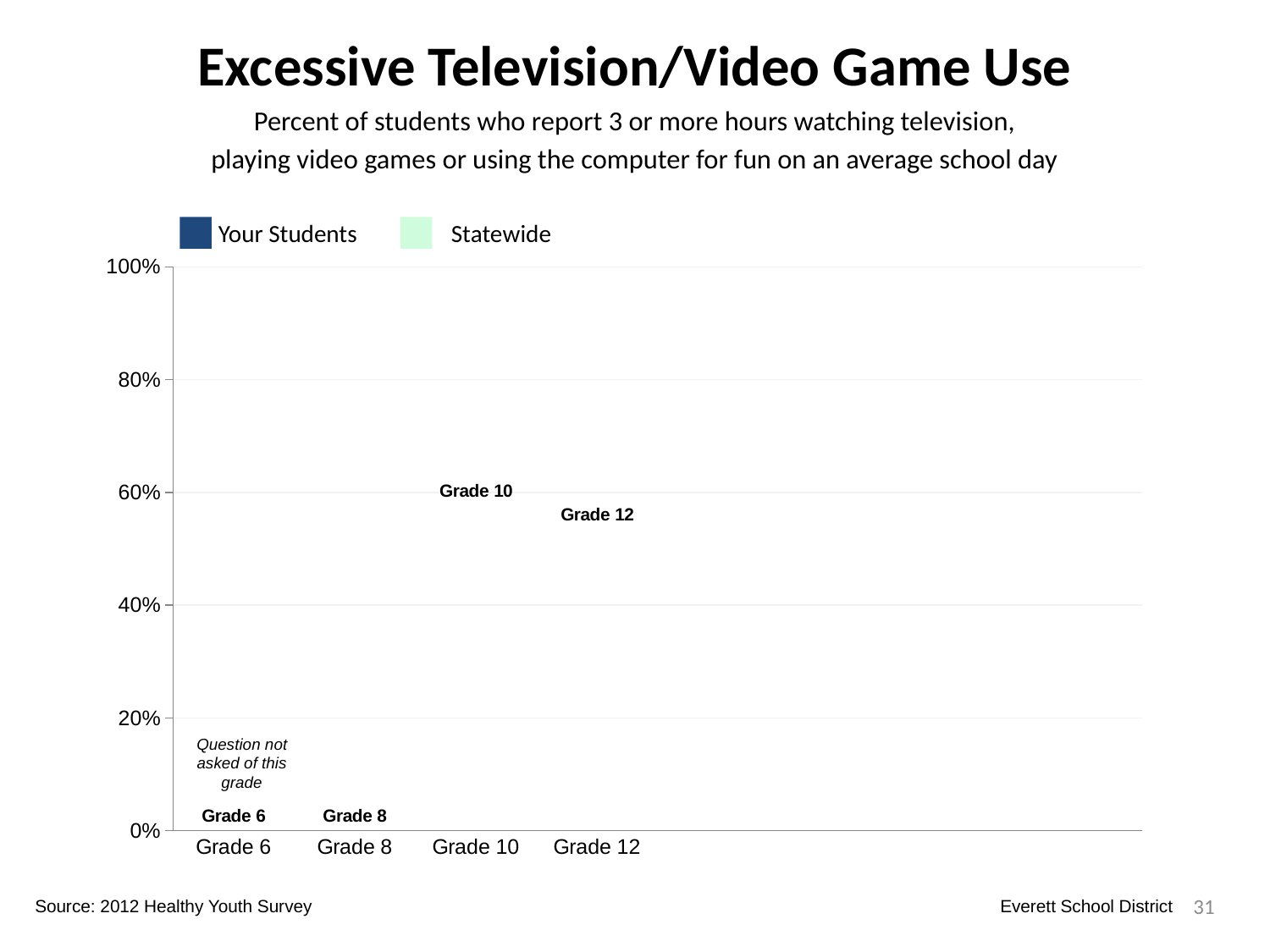
Which grade on the chart is marked with the note "Question not asked of this grade"? Grade 6 How many grade categories are shown on the x axis of the chart? 4 What is the lowest value shown on the chart's vertical axis? 0% Which grade is the first category on the chart's x axis? Grade 6 What is the highest value shown on the chart's vertical axis? 100% Which grade is the last category on the chart's x axis? Grade 12 What are the two series named in the chart's legend? Your Students and Statewide How many series does the chart's legend list? 2 What is the title of the chart on the slide? Excessive Television/Video Game Use